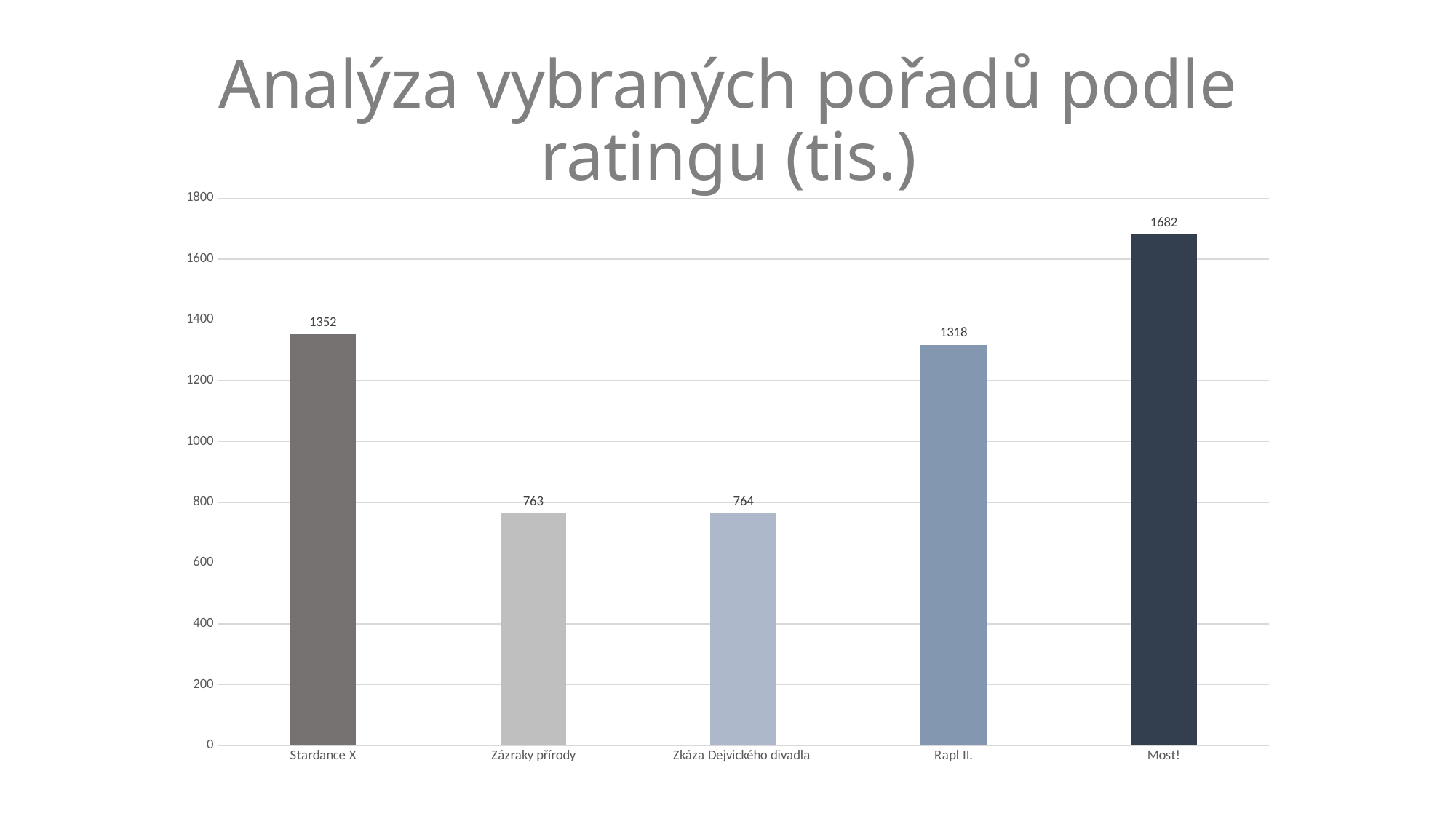
What is the rating value for Most!? 1682 How many programmes are shown in the chart? 5 What is the difference between the ratings of Zkáza Dejvického divadla and Zázraky přírody? 1 What is the title of the chart? Analýza vybraných pořadů podle ratingu (tis.) Which has a higher rating, Stardance X or Rapl II.? Stardance X What is the rating value for Rapl II.? 1318 Which programme has the lowest rating? Zázraky přírody What type of chart is shown on the slide? Bar chart What is the rating value for Stardance X? 1352 Which programme has the highest rating? Most! What is the rating value for Zázraky přírody? 763 What is the difference between the ratings of Most! and Stardance X? 330